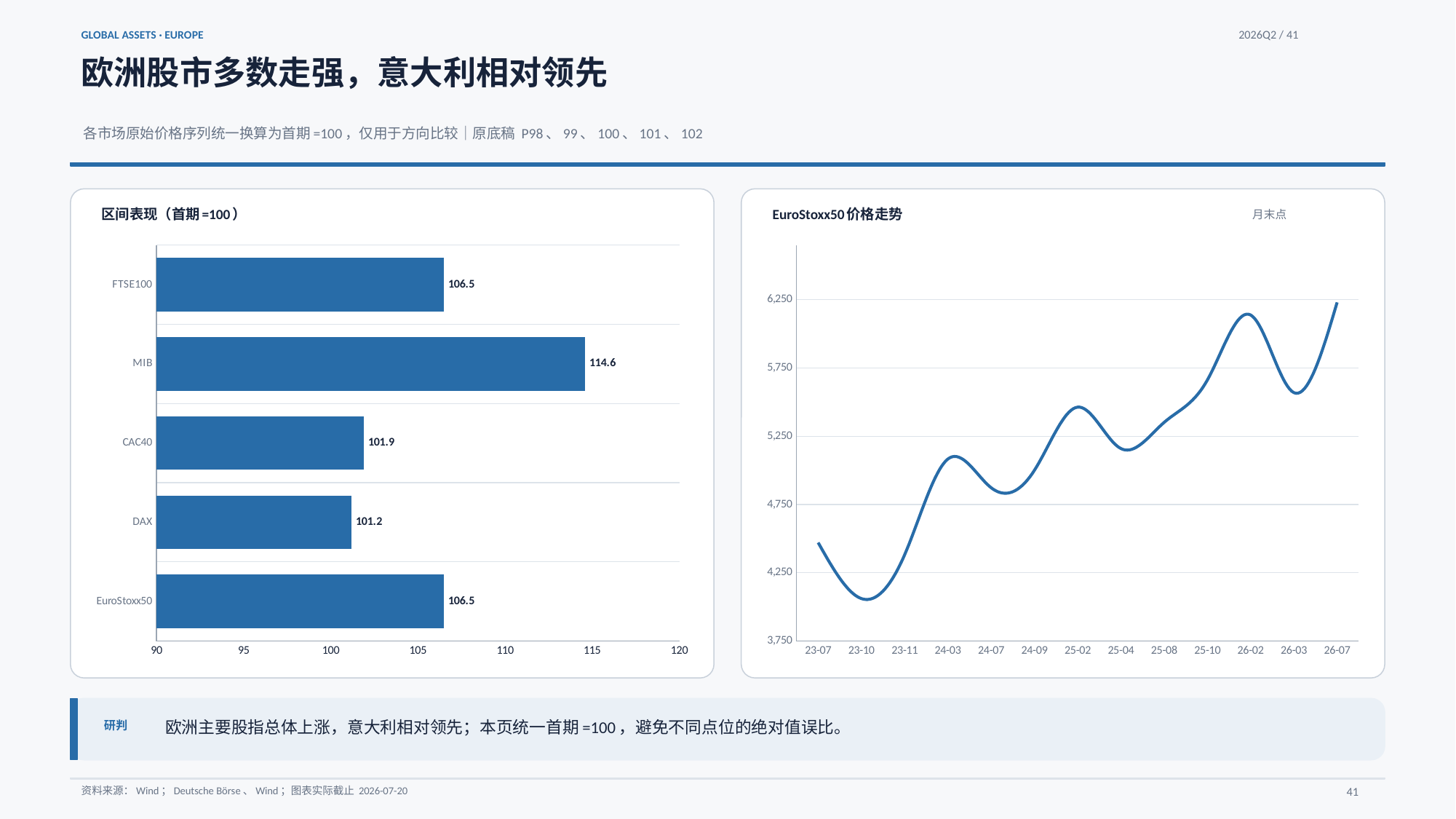
In the 区间表现（首期=100） chart, which index has the highest value? MIB In the 区间表现（首期=100） chart, what is the value for DAX? 101.2 In the 区间表现（首期=100） chart, which index has the lowest value? DAX In the EuroStoxx50 价格走势 chart, do values overall rise or fall from 23-07 to 26-07? Rise In the 区间表现（首期=100） chart, how many indices are shown? 5 In the 区间表现（首期=100） chart, what is the value for CAC40? 101.9 In the 区间表现（首期=100） chart, what is the value for MIB? 114.6 In the 区间表现（首期=100） chart, what is the difference between MIB and FTSE100? 8.1 In the 区间表现（首期=100） chart, which is larger, CAC40 or DAX? CAC40 In the EuroStoxx50 价格走势 chart, is the value at 23-10 greater or less than 4,250? less In the EuroStoxx50 价格走势 chart, is the value at 26-07 greater or less than 5,750? greater What kind of chart is the 区间表现（首期=100） chart? Bar chart